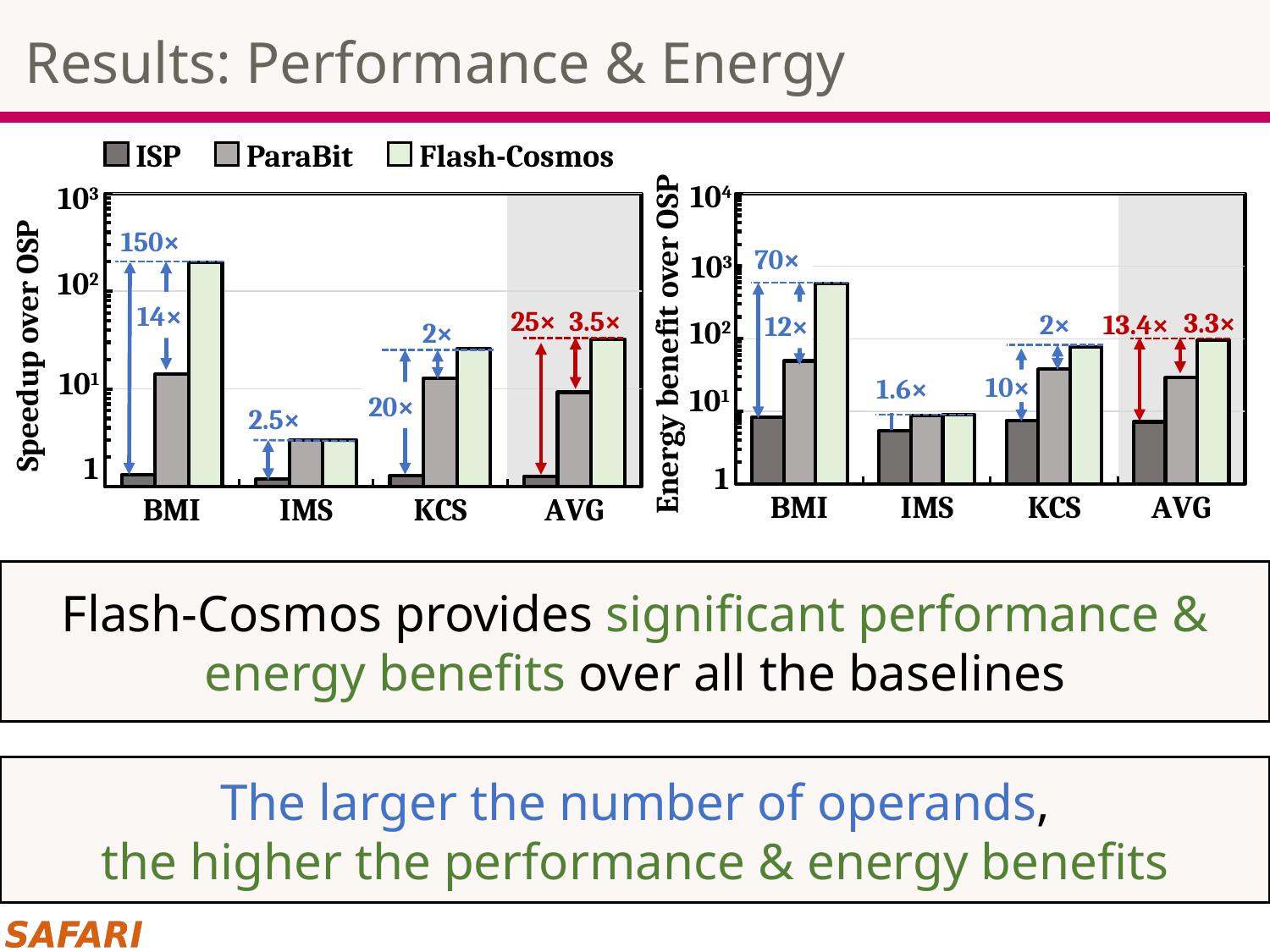
In the right chart, 'Energy benefit over OSP', what factor is annotated for Flash-Cosmos over ISP for BMI? 70× In the left chart, 'Speedup over OSP', which category has the shortest Flash-Cosmos bar? IMS In the left chart, 'Speedup over OSP', what speedup factor is annotated for Flash-Cosmos over ISP for BMI? 150× How many categories are shown on the x axis of the right chart, 'Energy benefit over OSP'? 4 What kind of chart is the left chart, 'Speedup over OSP'? bar chart In the right chart, 'Energy benefit over OSP', is the Flash-Cosmos bar for BMI greater or less than 100? greater In the left chart, 'Speedup over OSP', is the Flash-Cosmos bar for BMI greater or less than 100? greater In the right chart, 'Energy benefit over OSP', what factor is annotated for Flash-Cosmos over ISP for AVG? 13.4× In the left chart, 'Speedup over OSP', what factor is annotated for Flash-Cosmos over ParaBit for AVG? 3.5× In the left chart, 'Speedup over OSP', which is larger for BMI: the ParaBit bar or the Flash-Cosmos bar? Flash-Cosmos How many series does the legend list for the charts? 3 In the left chart, 'Speedup over OSP', which category has the tallest Flash-Cosmos bar? BMI